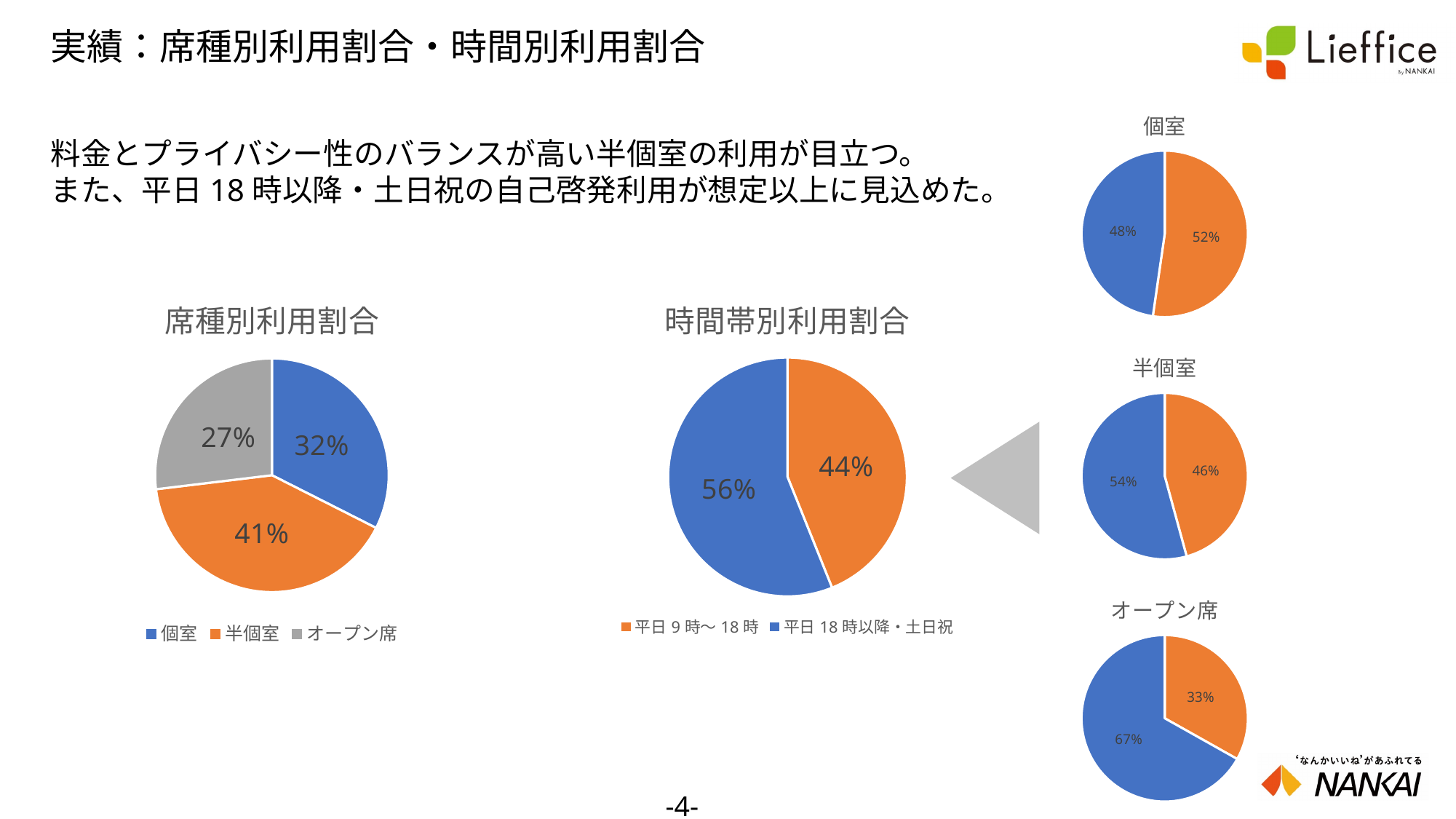
In the small 半個室 pie chart on the right, what value is shown on the blue slice? 54% In the 席種別利用割合 chart, what share does 半個室 have? 41% What kind of chart is the 時間帯別利用割合 chart? Pie chart In the 席種別利用割合 chart, which category has the smallest share? オープン席 In the 席種別利用割合 chart, what is the difference in percentage points between 半個室 and 個室? 9 In the 席種別利用割合 chart, what share does オープン席 have? 27% In the small オープン席 pie chart on the right, what value is shown on the blue slice? 67% In the 席種別利用割合 chart, which category has the largest share? 半個室 In the small 個室 pie chart on the right, what value is shown on the orange slice? 52% In the 時間帯別利用割合 chart, which is larger, 平日 9 時〜 18 時 or 平日 18 時以降・土日祝? 平日 18 時以降・土日祝 In the 時間帯別利用割合 chart, what share does 平日 18 時以降・土日祝 have? 56% In the 席種別利用割合 chart, how many categories does the legend list? 3